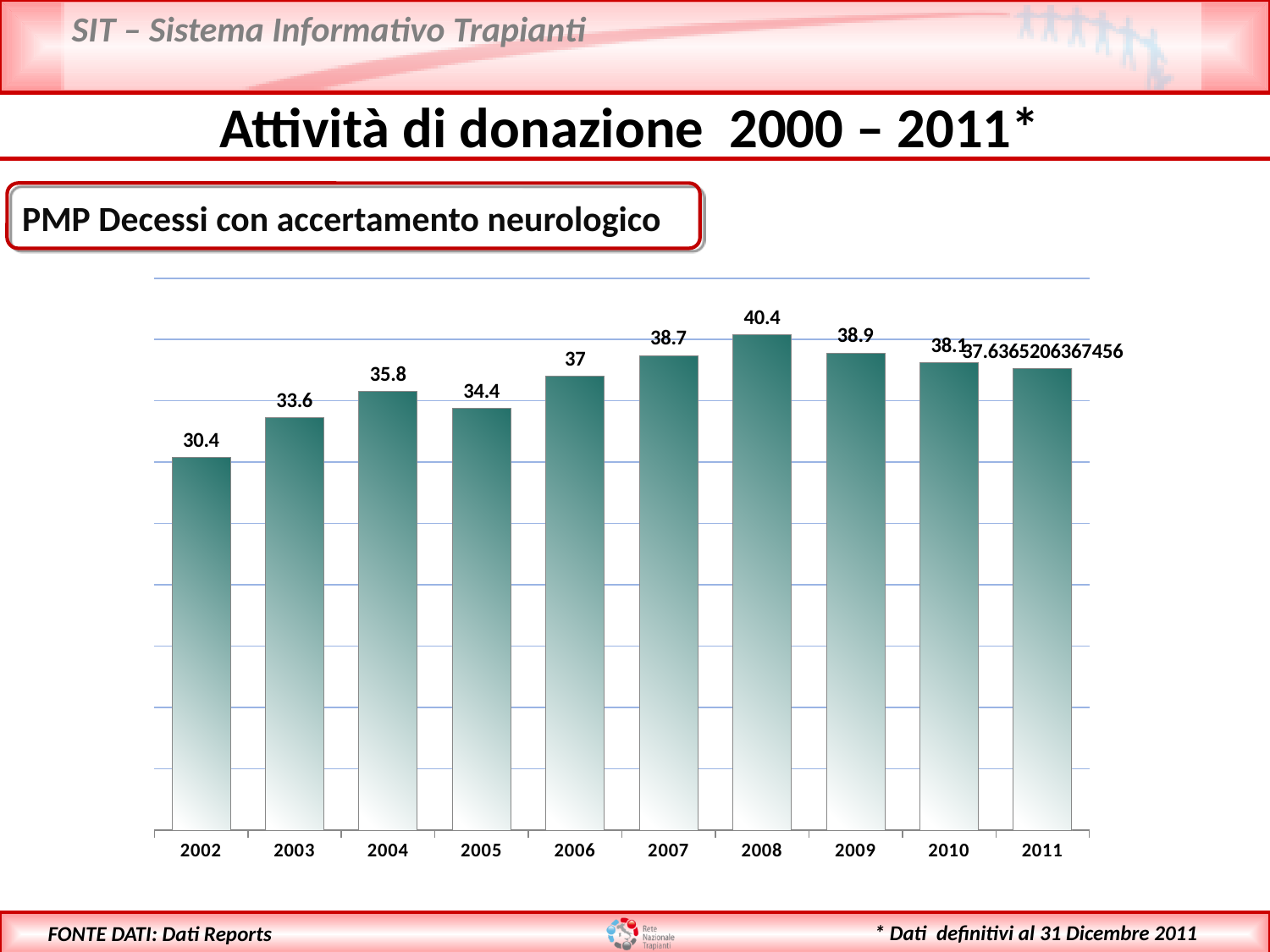
What is the difference between the values for 2008 and 2002? 10 Which is larger, the value for 2007 or the value for 2009? 2009 What is the difference between the values for 2004 and 2005? 1.4 What kind of chart is shown on the slide? Bar chart How many years are shown on the x axis? 10 What is the value for 2006? 37 What is the title shown in the box above the chart? PMP Decessi con accertamento neurologico Which year has the highest value? 2008 What is the value for 2010? 38.1 What is the value for 2008? 40.4 Which year has the lowest value? 2002 What is the value for 2002? 30.4